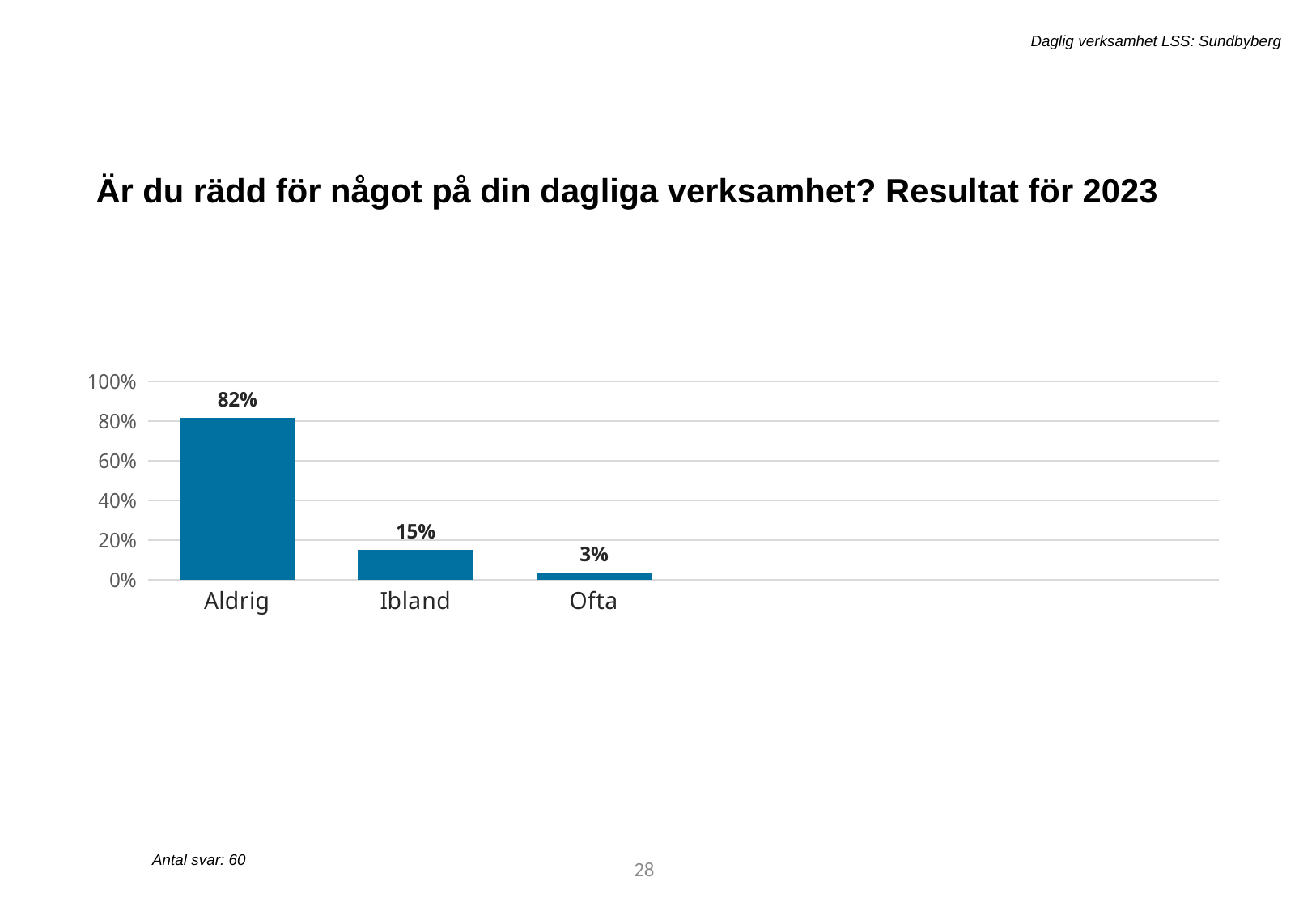
Which category has the highest value? Aldrig Do the values rise or fall from left to right along the x axis? fall Which category has the lowest value? Ofta What is the value for Aldrig? 82% What is the difference between the values for Ibland and Ofta? 12% What is the difference between the values for Aldrig and Ibland? 67% Is the value for Aldrig greater or less than 60%? greater What is the value for Ibland? 15% What kind of chart is shown on the slide? bar chart How many categories are shown on the x axis? 3 What is the value for Ofta? 3% Which is larger, the value for Ibland or the value for Ofta? Ibland